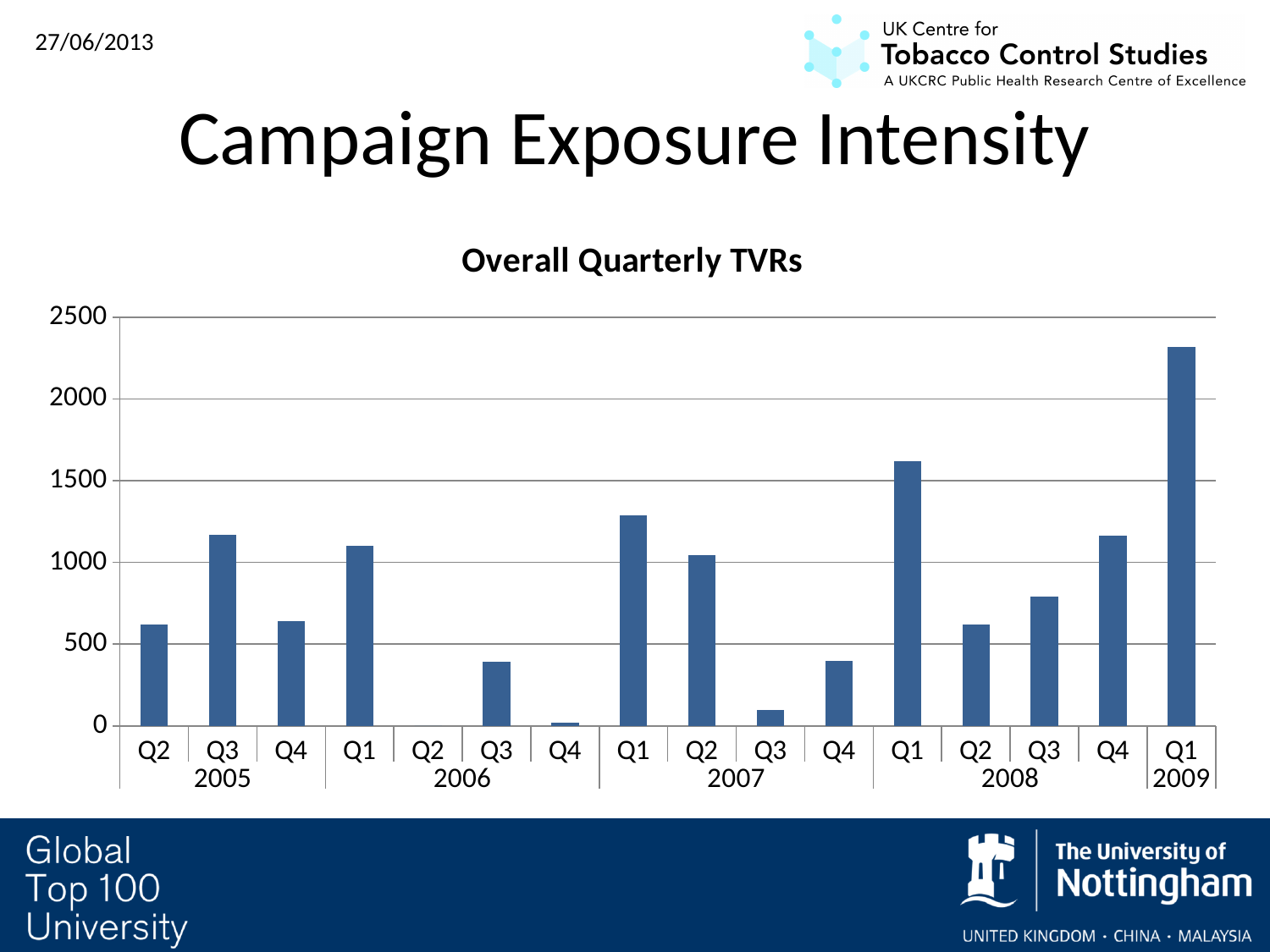
Which is larger, the value for Q3 2005 or the value for Q4 2005? Q3 2005 Is the value for Q3 2008 greater or less than 1000? less Which is larger, the value for Q1 2007 or the value for Q1 2008? Q1 2008 What is the highest value shown on the y axis of the chart? 2500 Is the value for Q3 2005 greater or less than 1000? greater What is the title of the chart? Overall Quarterly TVRs Which quarter has the highest bar in the chart? Q1 2009 Is the value for Q3 2007 greater or less than 500? less What type of chart is shown on the slide? bar chart How many quarters are plotted along the x axis of the chart? 16